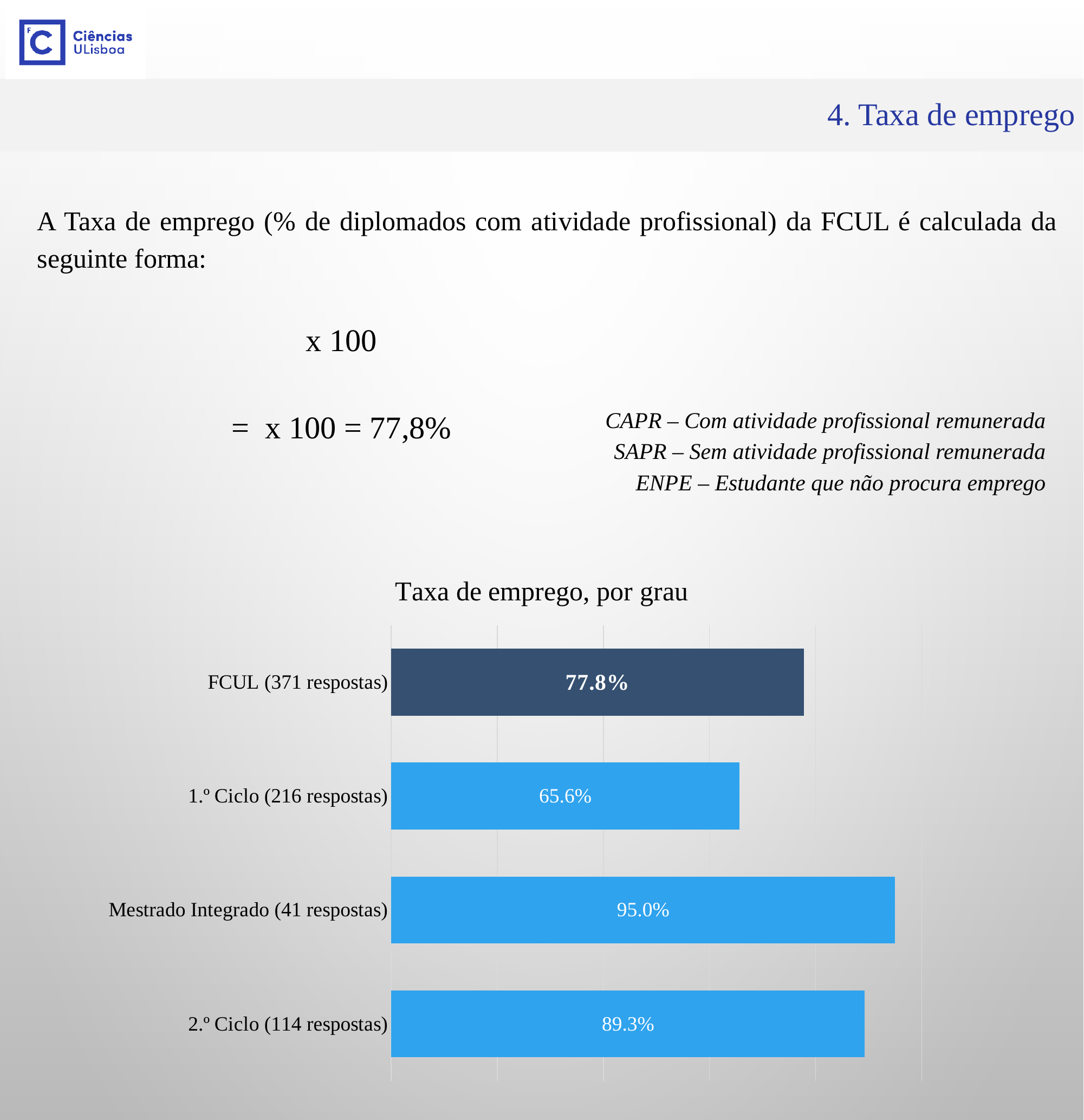
What is the employment rate shown for FCUL (371 respostas)? 77.8% What is the difference between the employment rates of Mestrado Integrado and 1.º Ciclo? 29.4% Which category has the lowest employment rate in the chart? 1.º Ciclo (216 respostas) What is the title of the chart? Taxa de emprego, por grau How many categories are shown in the chart? 4 Which category has the highest employment rate in the chart? Mestrado Integrado (41 respostas) What is the employment rate shown for 1.º Ciclo (216 respostas)? 65.6% What is the employment rate shown for Mestrado Integrado (41 respostas)? 95.0% What is the difference between the employment rates of 2.º Ciclo and FCUL? 11.5% What kind of chart is shown on the slide? Bar chart Which has a higher employment rate, 2.º Ciclo or 1.º Ciclo? 2.º Ciclo What is the employment rate shown for 2.º Ciclo (114 respostas)? 89.3%